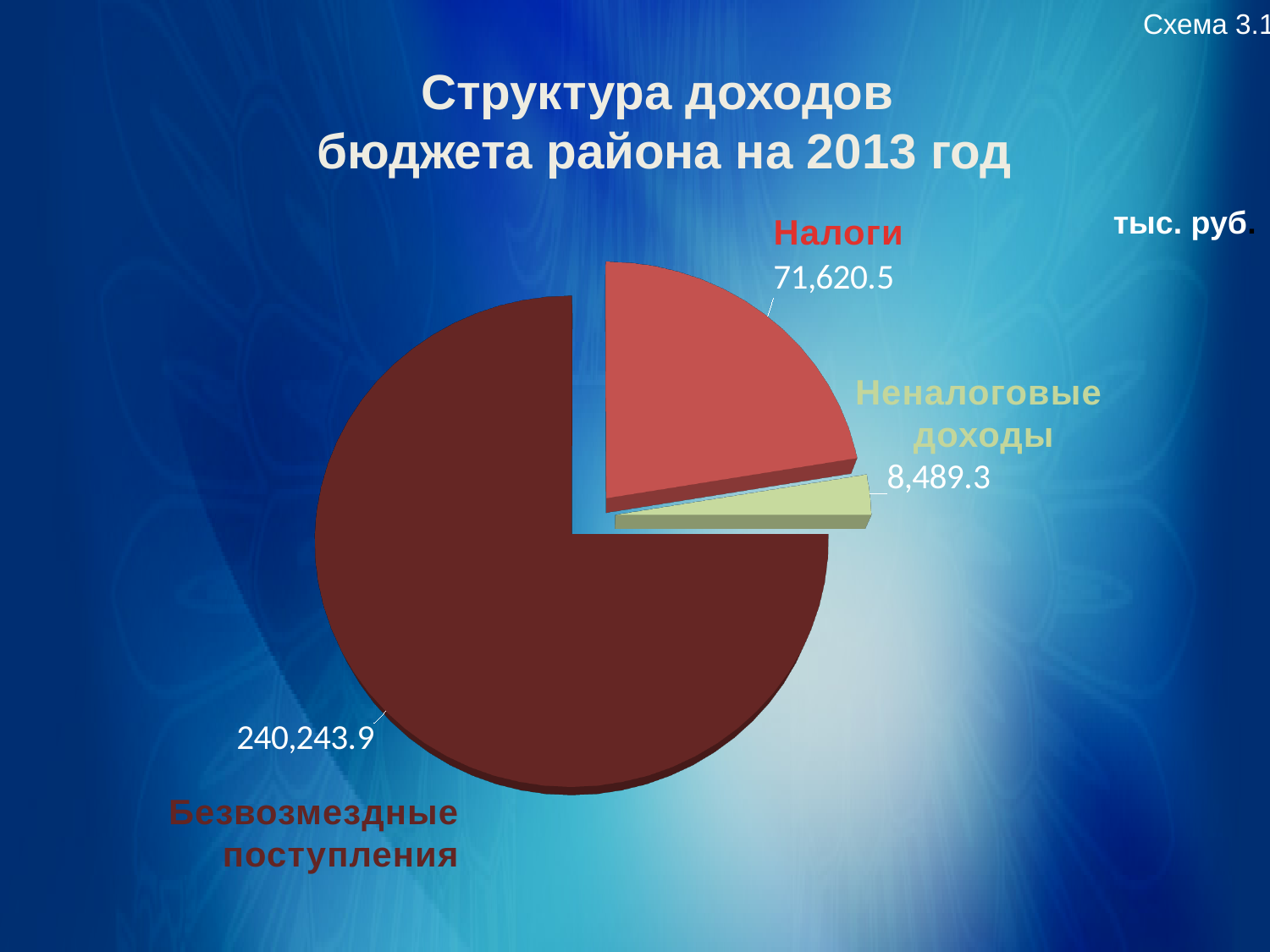
What is the value for Неналоговые доходы? 8,489.3 Which category has the largest slice of the pie? Безвозмездные поступления What kind of chart is shown on the slide? Pie chart How many slices does the pie chart have? 3 Which category has the smallest slice of the pie? Неналоговые доходы What unit of measurement is indicated for the chart values? тыс. руб. What is the difference between Безвозмездные поступления and Налоги? 168,623.4 What is the total of all three slices? 320,353.7 What is the value for Налоги? 71,620.5 Which is larger, Налоги or Неналоговые доходы? Налоги What is the difference between Налоги and Неналоговые доходы? 63,131.2 What is the value for Безвозмездные поступления? 240,243.9